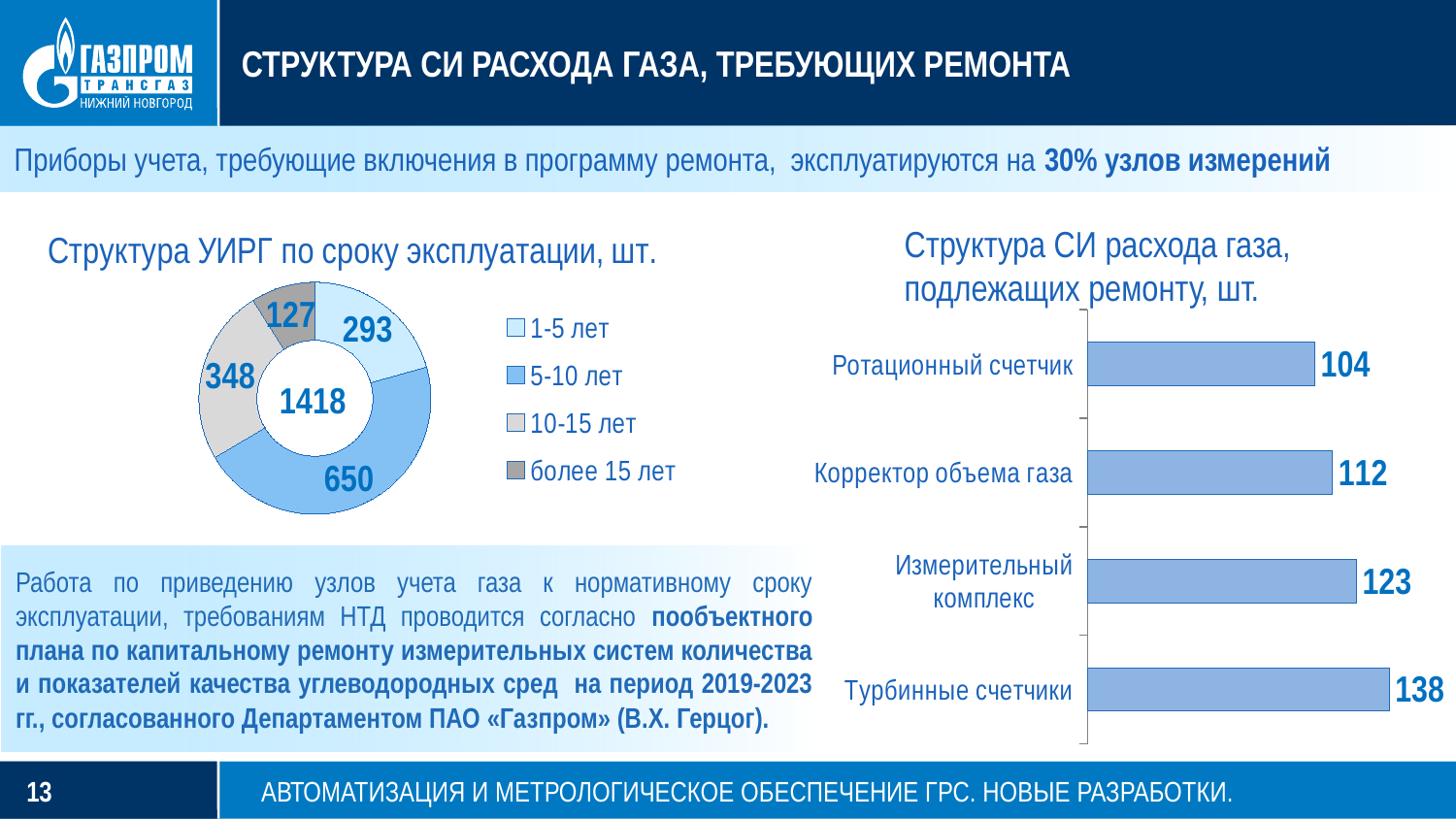
In the chart 'Структура СИ расхода газа, подлежащих ремонту, шт.', how many categories are shown? 4 In the chart 'Структура УИРГ по сроку эксплуатации, шт.', what is the value for более 15 лет? 127 In the chart 'Структура УИРГ по сроку эксплуатации, шт.', which is larger: 1-5 лет or 10-15 лет? 10-15 лет In the chart 'Структура СИ расхода газа, подлежащих ремонту, шт.', which category has the lowest value? Ротационный счетчик In the chart 'Структура УИРГ по сроку эксплуатации, шт.', how many entries does the legend list? 4 In the chart 'Структура СИ расхода газа, подлежащих ремонту, шт.', which category has the highest value? Турбинные счетчики In the chart 'Структура СИ расхода газа, подлежащих ремонту, шт.', what is the value for Ротационный счетчик? 104 In the chart 'Структура СИ расхода газа, подлежащих ремонту, шт.', what is the difference between Турбинные счетчики and Корректор объема газа? 26 In the chart 'Структура УИРГ по сроку эксплуатации, шт.', which segment is the largest? 5-10 лет What type of chart is 'Структура СИ расхода газа, подлежащих ремонту, шт.'? Bar chart In the chart 'Структура СИ расхода газа, подлежащих ремонту, шт.', what is the value for Турбинные счетчики? 138 In the chart 'Структура УИРГ по сроку эксплуатации, шт.', what is the value for 5-10 лет? 650